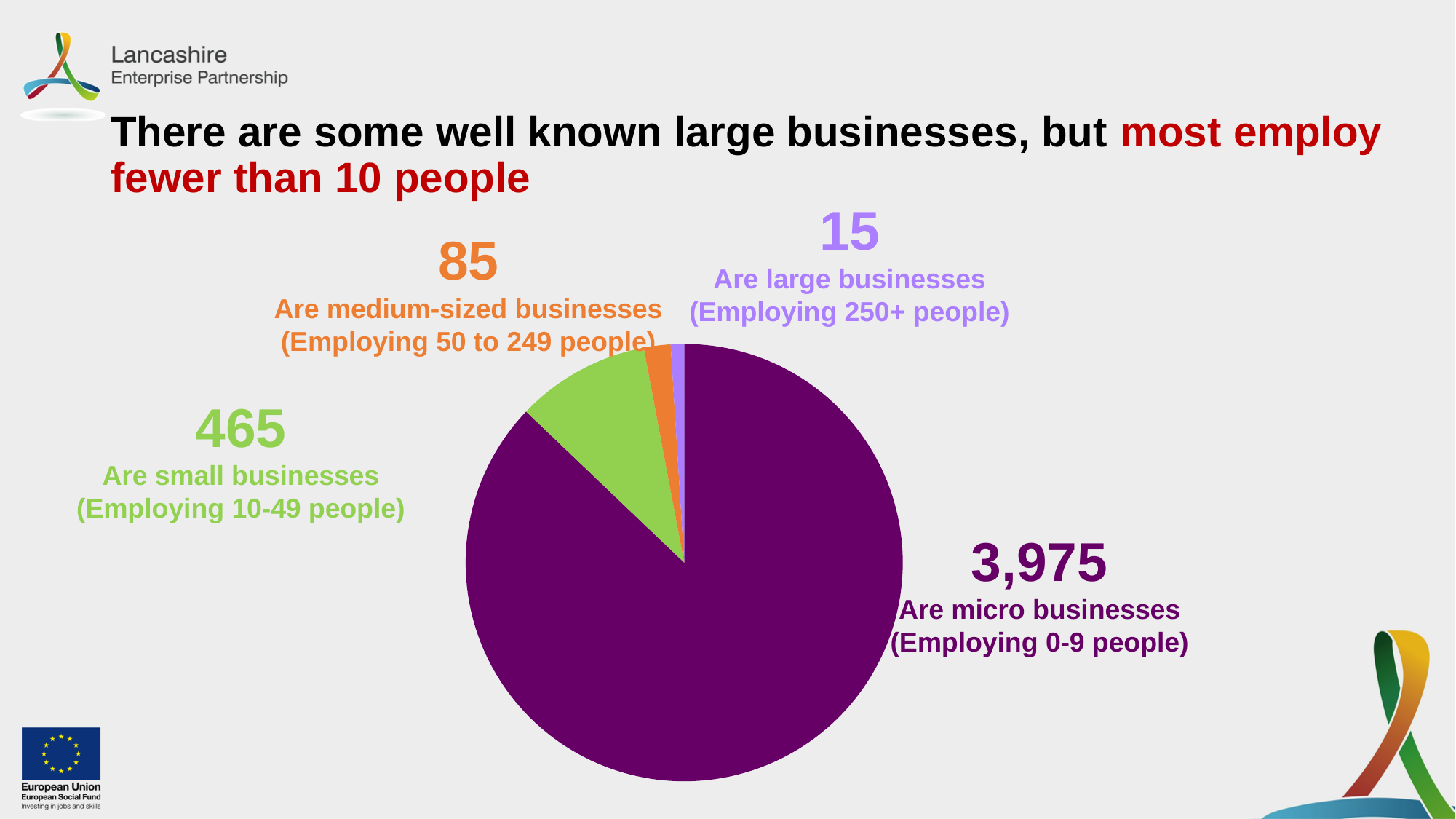
Which business size category has the largest slice of the pie chart? Micro businesses (Employing 0-9 people) What is the difference between the number of small businesses and the number of medium-sized businesses? 380 Which business size category has the smallest slice of the pie chart? Large businesses (Employing 250+ people) How many micro businesses (employing 0-9 people) are shown on the pie chart? 3,975 Which is larger: the number of medium-sized businesses or the number of large businesses? Medium-sized businesses How many large businesses (employing 250+ people) are shown on the pie chart? 15 What is the total number of businesses across all four slices of the pie chart? 4,540 How many medium-sized businesses (employing 50 to 249 people) are shown on the pie chart? 85 How many small businesses (employing 10-49 people) are shown on the pie chart? 465 What kind of chart is shown on the slide? Pie chart What colour is the slice representing micro businesses? Purple How many categories does the pie chart show? 4